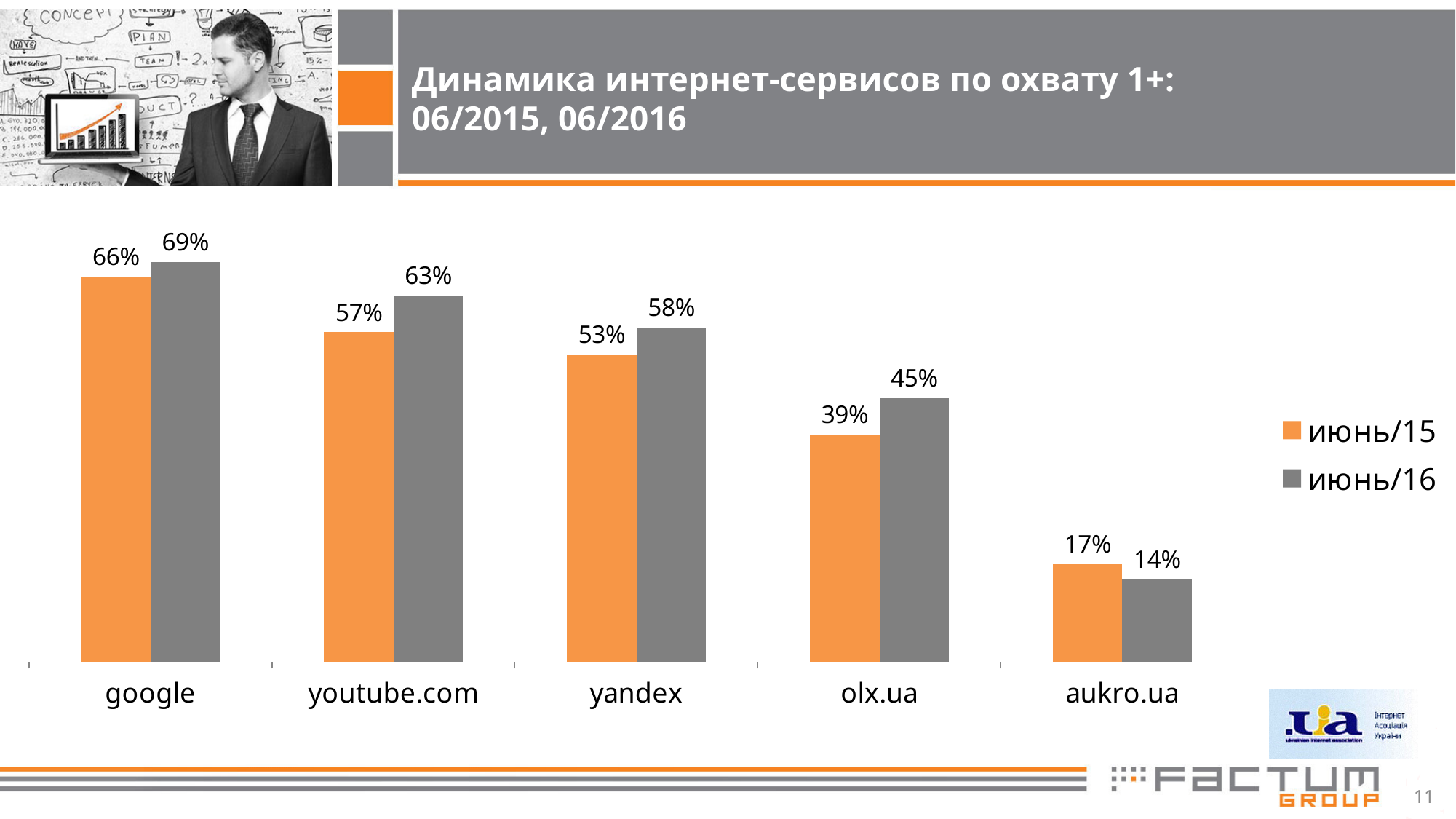
What is the value for aukro.ua in the июнь/16 series? 14% How many series does the legend list? 2 What is the value for google in the июнь/16 series? 69% How many categories are shown on the x axis? 5 What is the difference between the июнь/15 and июнь/16 values for aukro.ua? 3% Which is larger for yandex: the июнь/15 value or the июнь/16 value? июнь/16 What kind of chart is shown on the slide? bar chart Which colour represents the июнь/15 series? orange Which category has the highest value in the июнь/16 series? google Which category has the lowest value in the июнь/15 series? aukro.ua What is the value for olx.ua in the июнь/15 series? 39% What is the difference between the июнь/16 and июнь/15 values for olx.ua? 6%